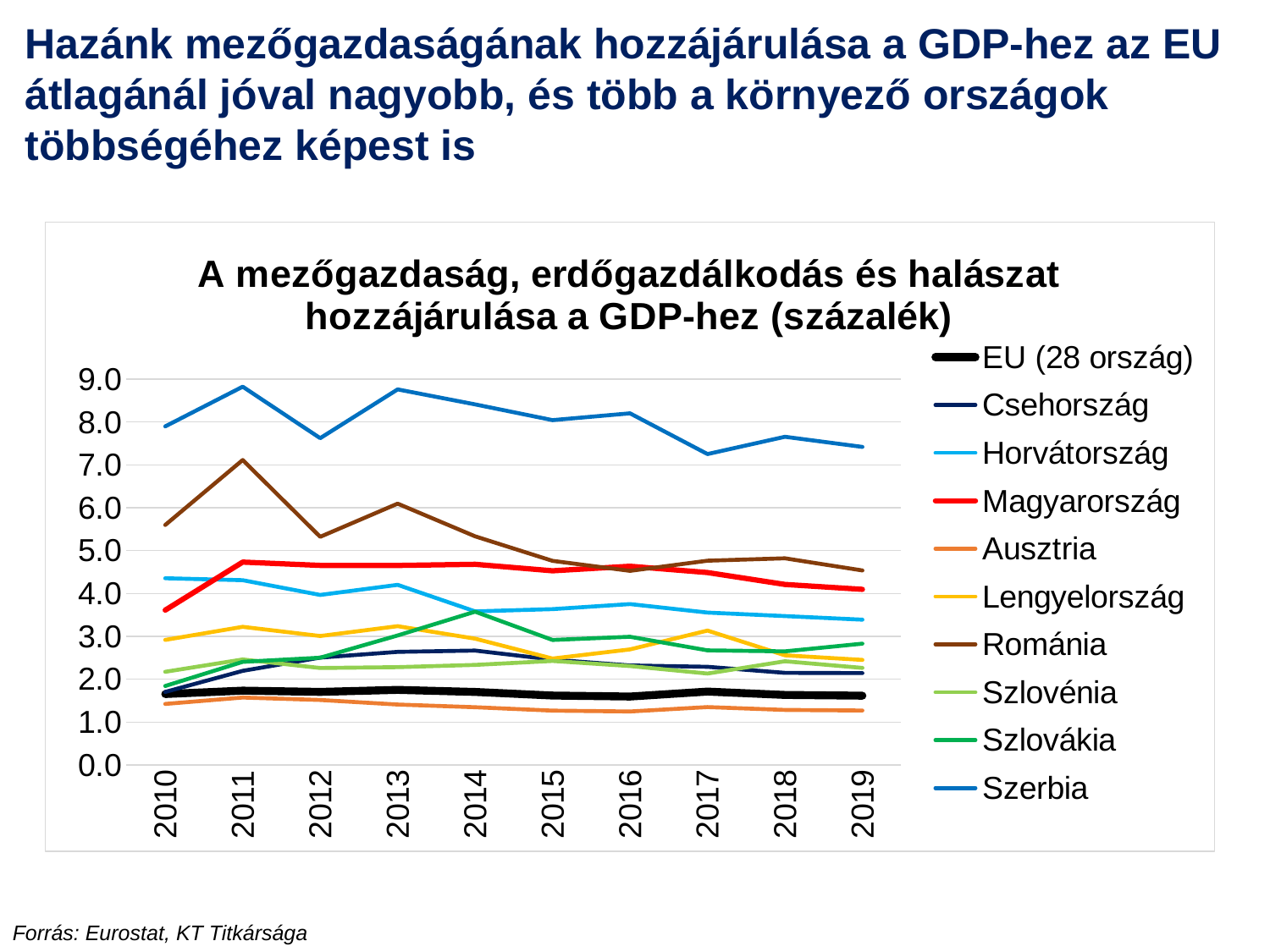
Is the value for Románia in 2011 greater or less than 6.0? greater Is the value for EU (28 ország) in 2010 greater or less than 2.0? less Which country has the highest value in 2019? Szerbia How many series does the legend list? 10 Which series has the lowest value in 2019? Ausztria Is the value for Magyarország in 2019 greater or less than 5.0? less Does the line for Szerbia rise or fall from 2013 to 2019? fall In 2010, which is larger: the value for Szerbia or the value for Románia? Szerbia How many years are shown on the x axis? 10 What kind of chart is shown on the slide? line chart What colour is the line for Magyarország? red